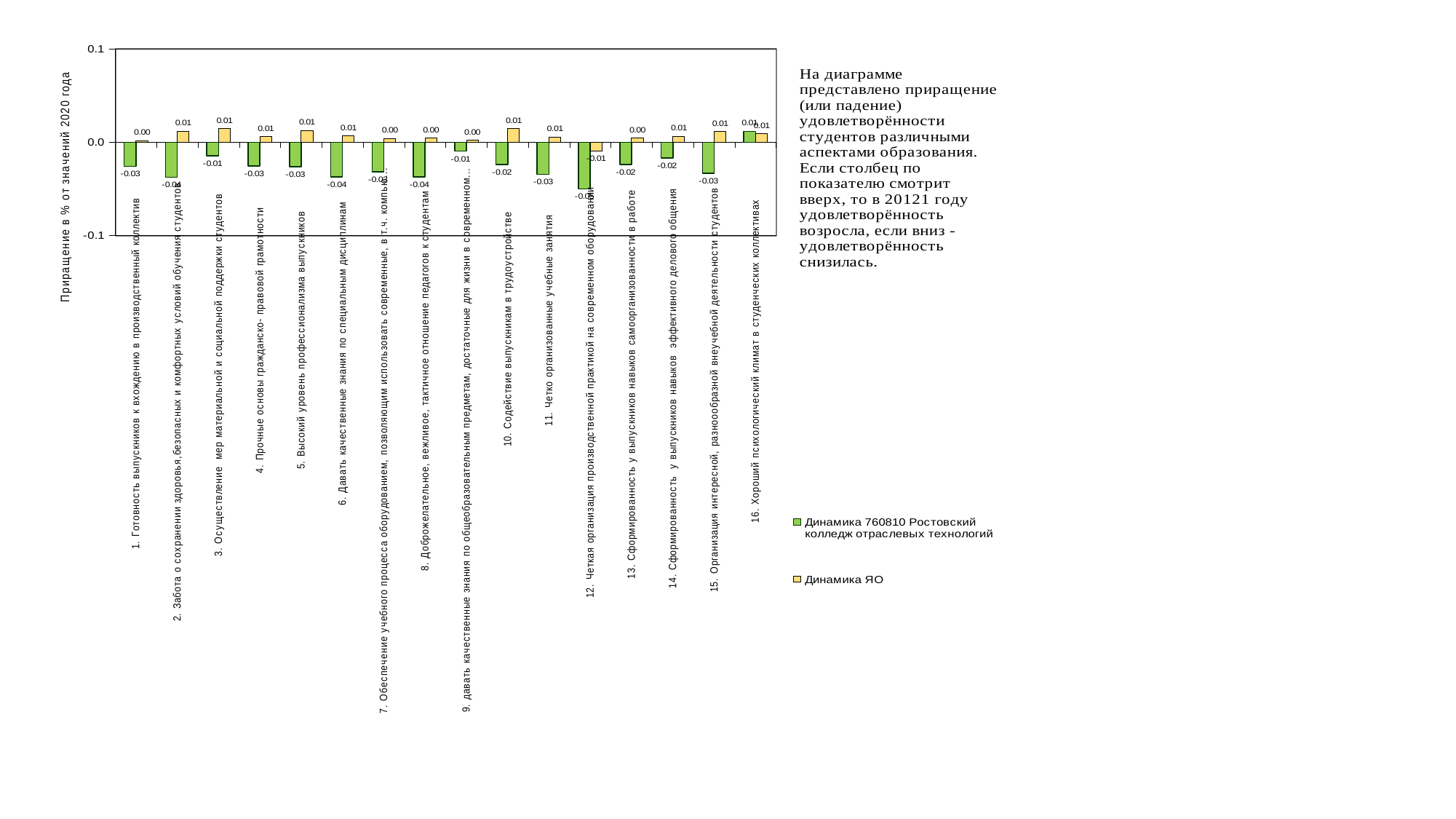
How many categories are plotted along the x axis? 16 For which category is the value of the series 'Динамика 760810 Ростовский колледж отраслевых технологий' the highest? 16. Хороший психологический климат в студенческих коллективах For category '6. Давать качественные знания по специальным дисциплинам', what is the difference between the 'Динамика ЯО' value and the 'Динамика 760810 Ростовский колледж отраслевых технологий' value? 0.05 For which category is the value of the series 'Динамика 760810 Ростовский колледж отраслевых технологий' the lowest? 12. Четкая организация производственной практикой на современном оборудовании Is the value of the series 'Динамика 760810 Ростовский колледж отраслевых технологий' for category '12. Четкая организация производственной практикой на современном оборудовании' greater or less than 0.0? less What is the value of the series 'Динамика ЯО' for category '12. Четкая организация производственной практикой на современном оборудовании'? -0.01 What is the value of the series 'Динамика ЯО' for category '10. Содействие выпускникам в трудоустройстве'? 0.01 What is the value of the series 'Динамика 760810 Ростовский колледж отраслевых технологий' for category '3. Осуществление мер материальной и социальной поддержки студентов'? -0.01 What is the value of the series 'Динамика 760810 Ростовский колледж отраслевых технологий' for category '6. Давать качественные знания по специальным дисциплинам'? -0.04 What kind of chart is shown on the slide? bar chart What is the title of the vertical axis? Приращение в % от значений 2020 года How many series does the legend list? 2